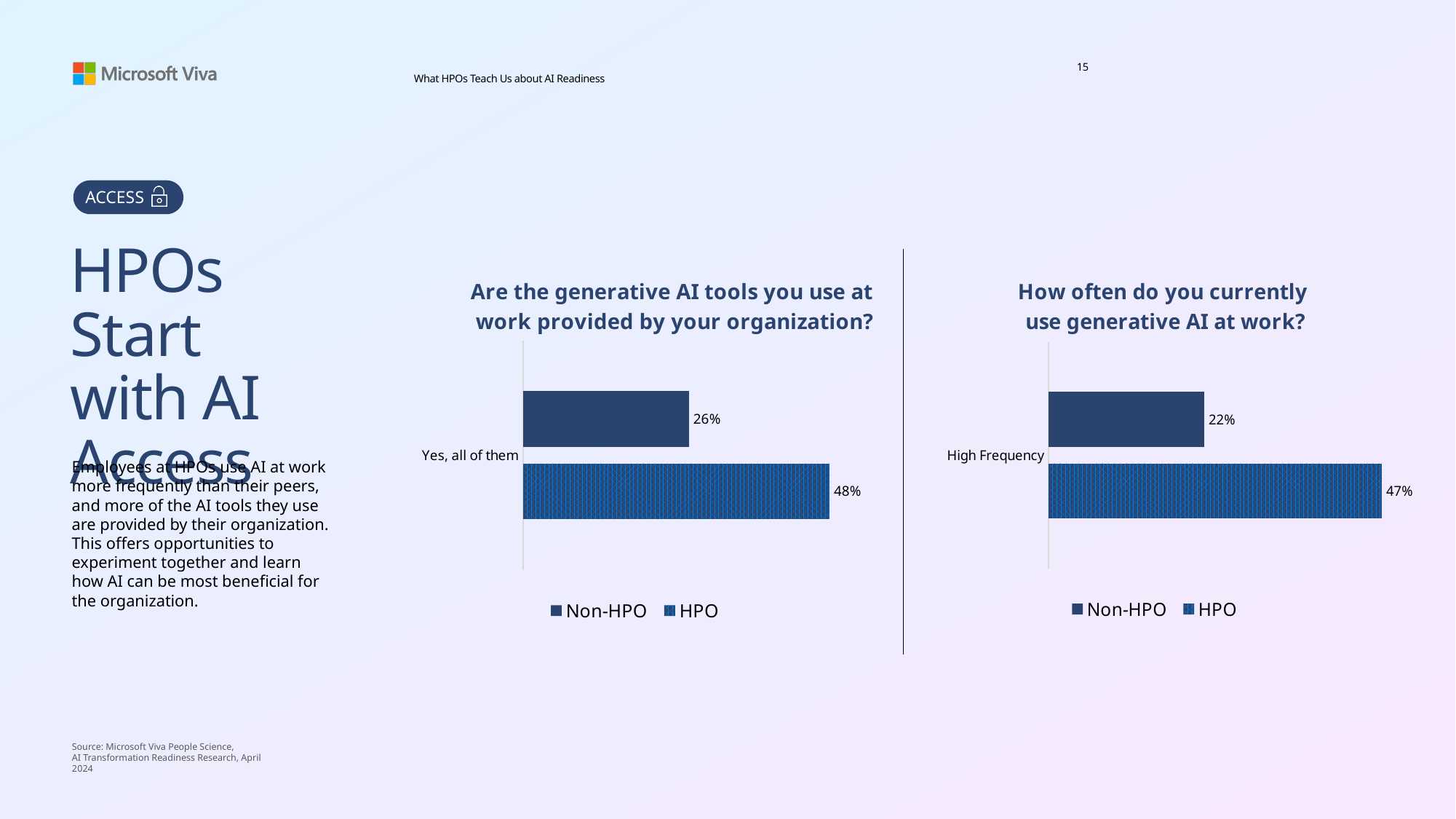
In the chart titled "How often do you currently use generative AI at work?", what is the value for Non-HPO? 22% In the chart titled "How often do you currently use generative AI at work?", what is the value for HPO? 47% In the chart titled "Are the generative AI tools you use at work provided by your organization?", what is the value for HPO? 48% In the left chart, what is the difference between the HPO and Non-HPO values? 22% What is the category label shown on the right chart? High Frequency In the right chart, which series has the smaller value, HPO or Non-HPO? Non-HPO What is the category label shown on the left chart? Yes, all of them How many series does the legend of the right chart list? 2 In the chart titled "Are the generative AI tools you use at work provided by your organization?", what is the value for Non-HPO? 26% In the left chart, which series has the larger value, HPO or Non-HPO? HPO In the right chart, what is the difference between the HPO and Non-HPO values? 25% What kind of chart is the left chart? Bar chart